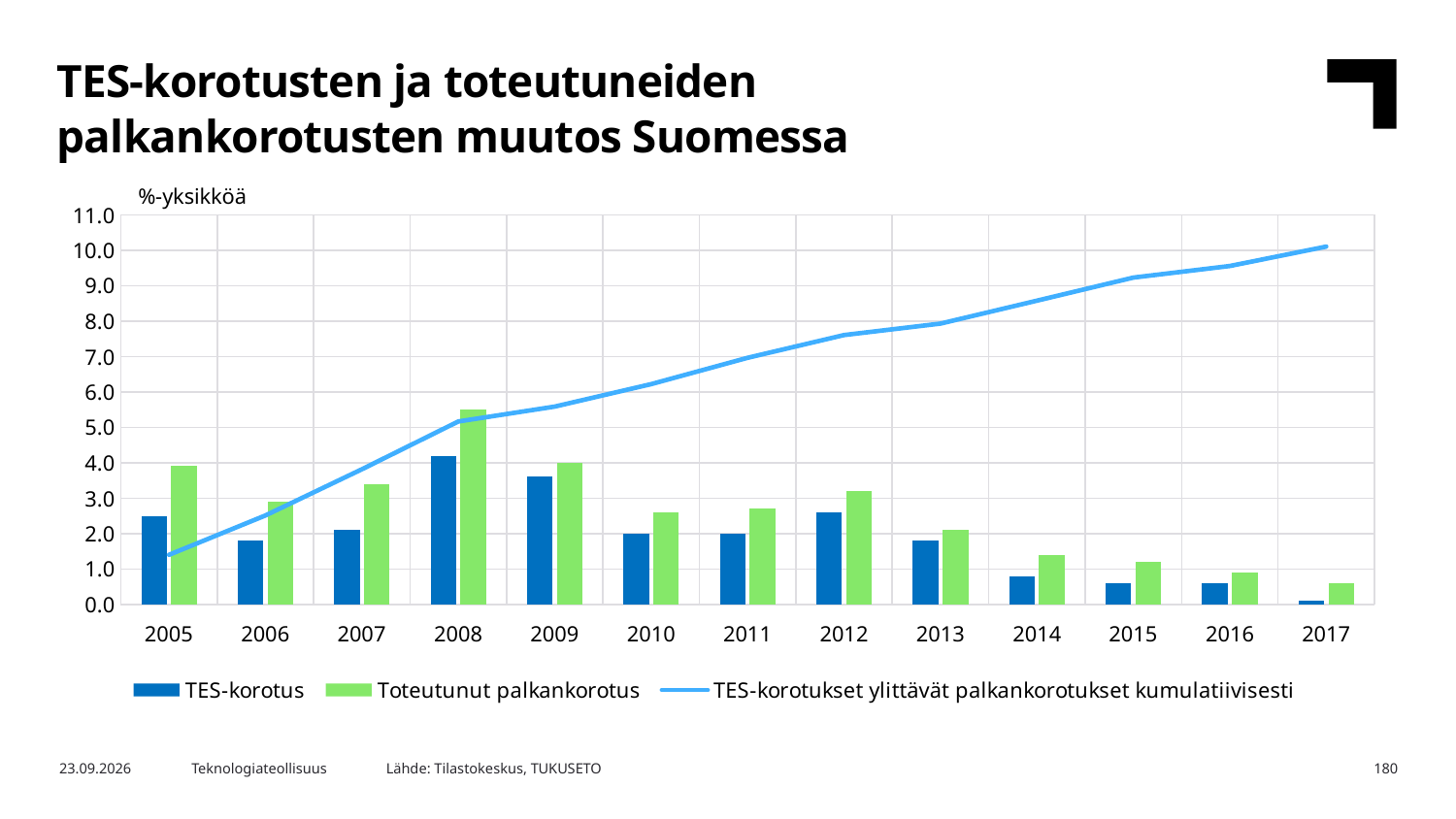
What kind of chart is shown on the slide? A bar chart combined with a line Is the TES-korotus value for 2008 greater or less than 4.0? greater Is the TES-korotus value for 2014 greater or less than 1.0? less In 2005, which is larger: TES-korotus or Toteutunut palkankorotus? Toteutunut palkankorotus In which year is the TES-korotus bar the lowest? 2017 Is the Toteutunut palkankorotus value for 2005 greater or less than 3.0? greater In which year is the Toteutunut palkankorotus bar the highest? 2008 In which year is the TES-korotus bar the highest? 2008 Does the line 'TES-korotukset ylittävät palkankorotukset kumulatiivisesti' rise or fall from 2005 to 2017? It rises What unit label is shown above the y axis? %-yksikköä How many years are shown on the x axis? 13 How many series does the legend list? 3